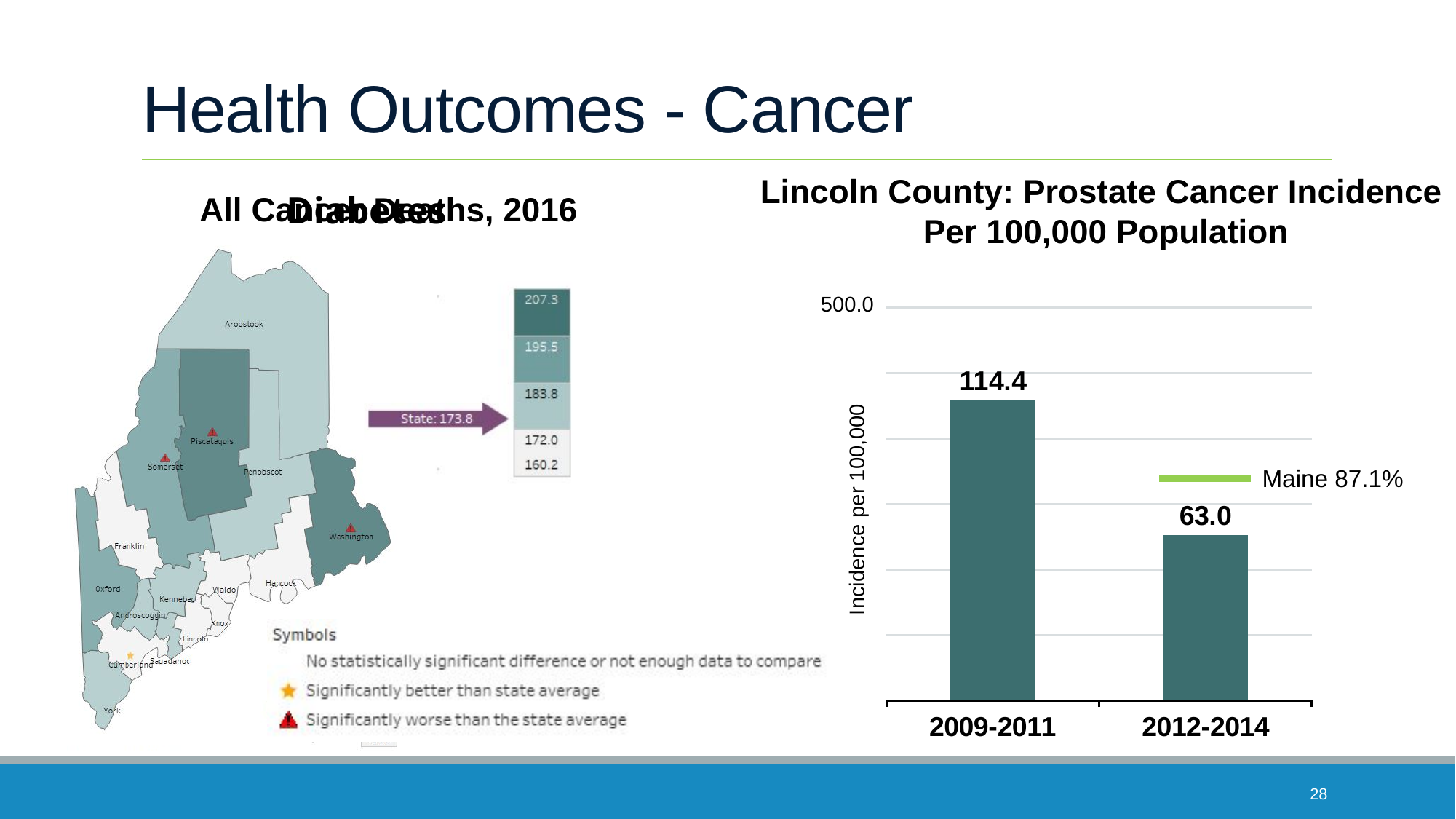
How many bars are shown in the Lincoln County prostate cancer incidence chart? 2 In the Lincoln County prostate cancer incidence chart, what is the difference between the 2009-2011 and 2012-2014 values? 51.4 In the Lincoln County prostate cancer incidence chart, is the value for 2009-2011 greater or less than 500.0? less What is the label on the y axis of the Lincoln County prostate cancer incidence chart? Incidence per 100,000 In the Lincoln County prostate cancer incidence chart, which period has the lower incidence? 2012-2014 In the Lincoln County prostate cancer incidence chart, is the value for 2009-2011 larger or smaller than the value for 2012-2014? larger In the Lincoln County prostate cancer incidence chart, what is the value for 2012-2014? 63.0 In the Lincoln County prostate cancer incidence chart, which period has the higher incidence? 2009-2011 In the Lincoln County prostate cancer incidence chart, does the incidence rise or fall from 2009-2011 to 2012-2014? fall In the Lincoln County prostate cancer incidence chart, what is the value for 2009-2011? 114.4 What value is shown for the Maine reference line in the Lincoln County prostate cancer incidence chart? 87.1% What type of chart is the Lincoln County prostate cancer incidence chart? bar chart